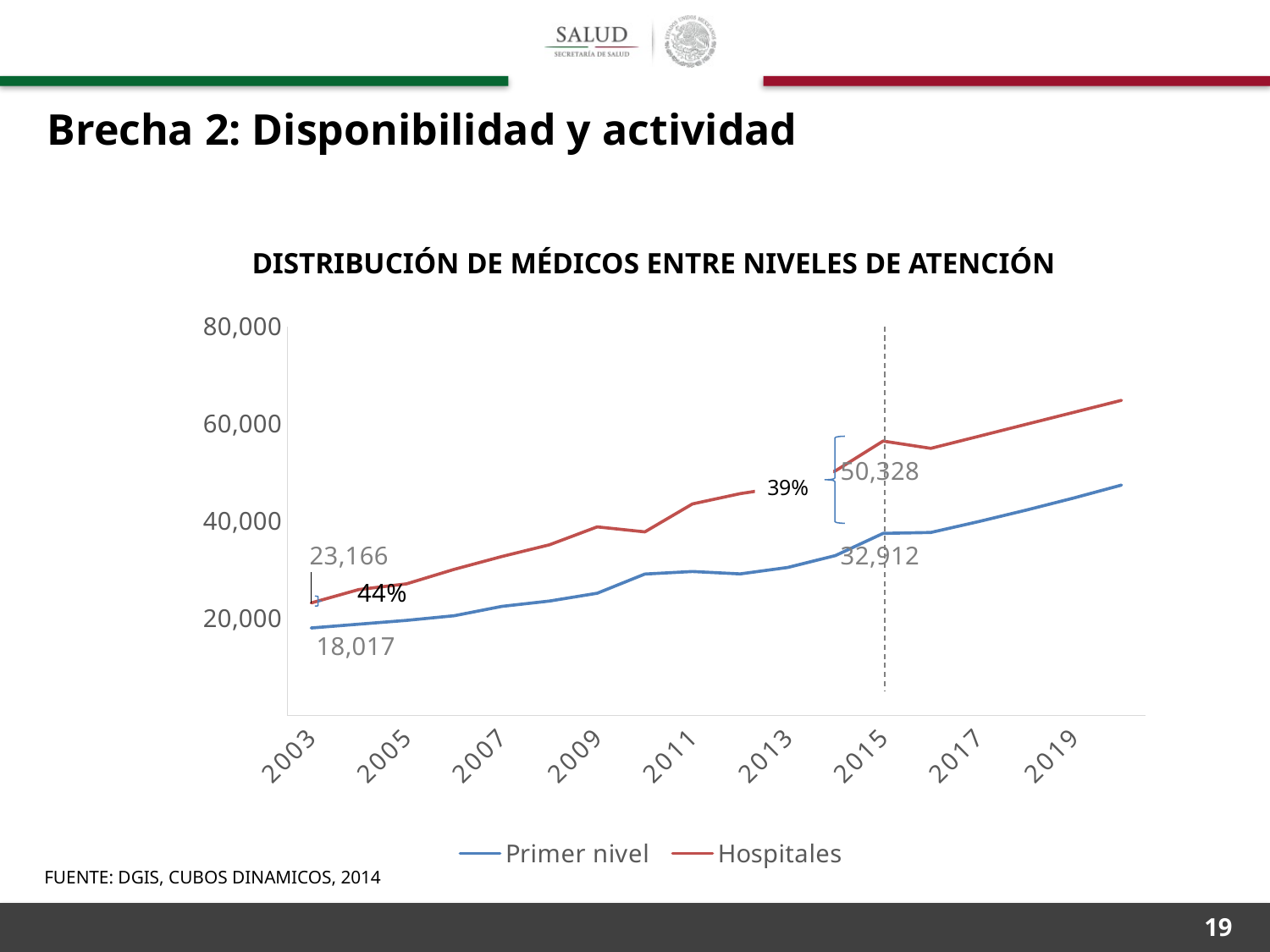
How many series does the legend list? 2 What is the value for Primer nivel in 2003? 18,017 Does the Primer nivel line rise or fall from 2003 to 2019? rise What is the value for Hospitales in 2003? 23,166 Which series has the higher value in 2015, Primer nivel or Hospitales? Hospitales What is the title of the chart? DISTRIBUCIÓN DE MÉDICOS ENTRE NIVELES DE ATENCIÓN Is the value for Primer nivel in 2019 greater or less than 60,000? less What is the difference between Hospitales and Primer nivel in 2003? 5,149 What kind of chart is shown on the slide? line chart